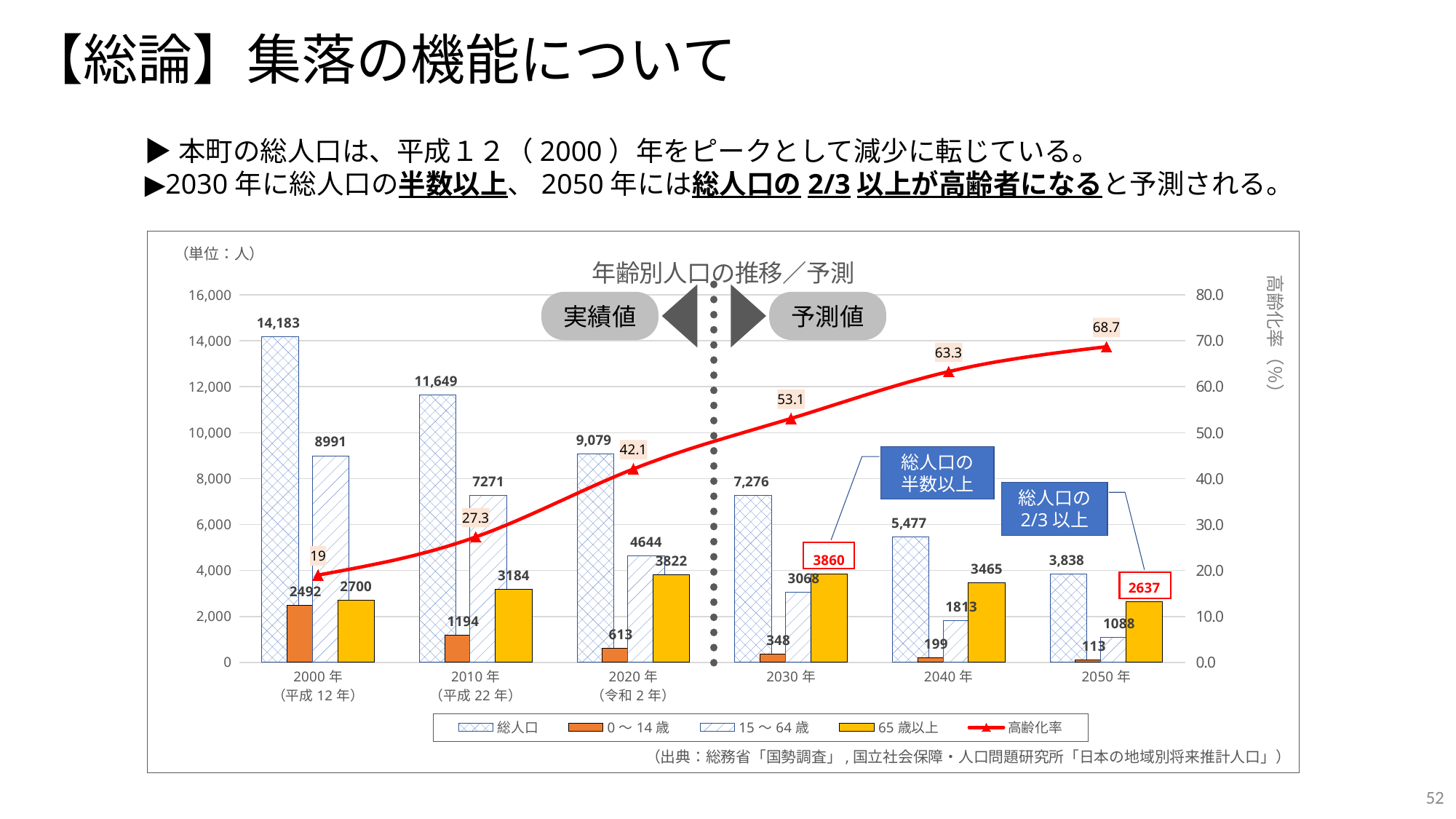
How many years (categories) are shown on the x axis? 6 Which is larger in 2040年: the 15～64歳 bar or the 65歳以上 bar? 65歳以上 Which year has the lowest 総人口 value? 2050年 Does the 高齢化率 line rise or fall from 2000年 to 2050年? rise What is the difference between the 総人口 values for 2000年 and 2010年? 2,534 What is the total population (総人口) shown for 2000年 in the chart? 14,183 What is the value of the 65歳以上 bar for 2030年? 3860 How many series does the legend list? 5 Which year has the highest 65歳以上 value? 2030年 What is the 高齢化率 value shown for 2050年? 68.7 What is the title of the chart? 年齢別人口の推移／予測 What is the value of the 0～14歳 bar for 2020年? 613